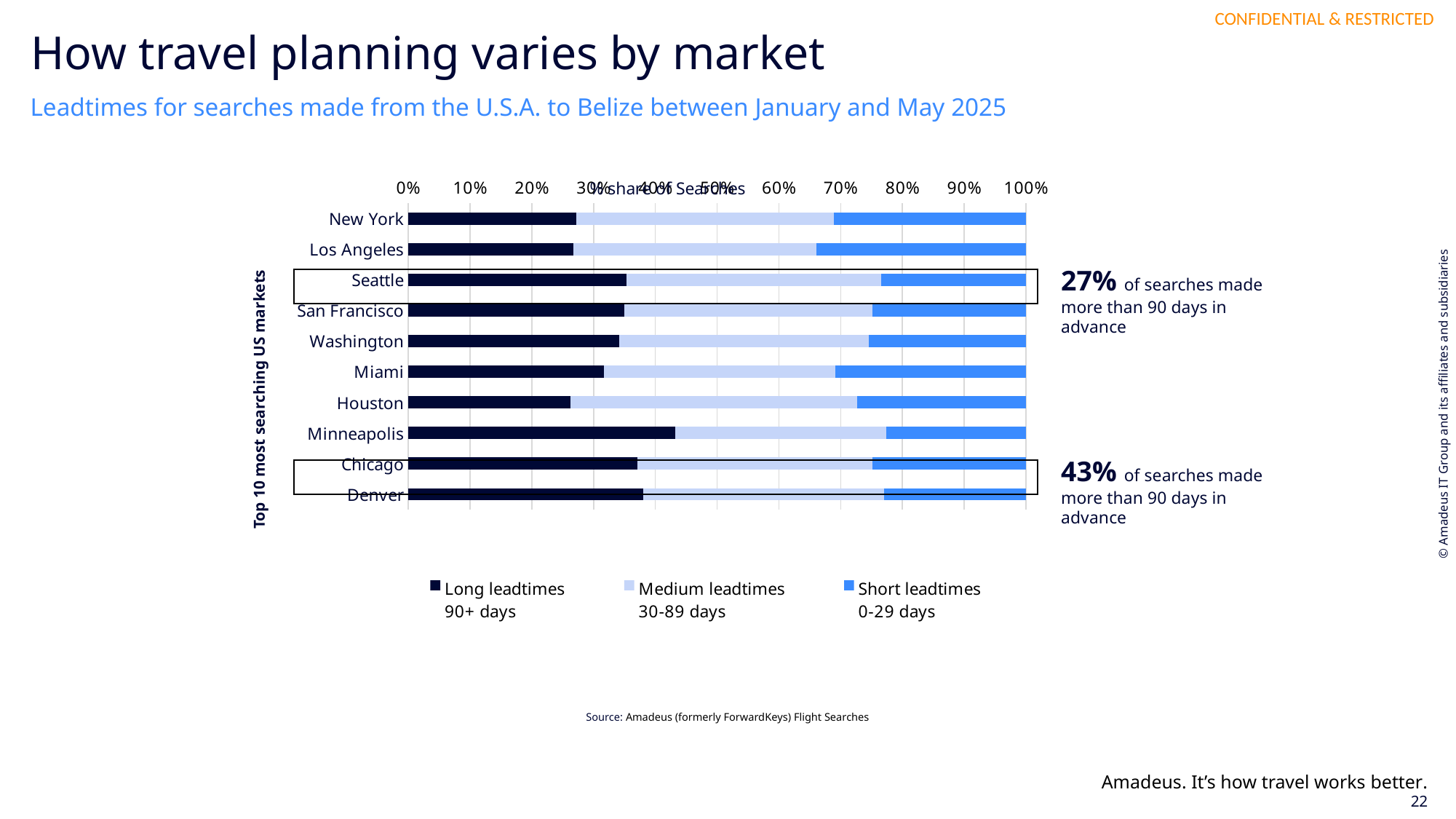
How many US markets are plotted on the chart? 10 Is the long leadtimes (90+ days) share for Seattle greater or less than 30%? greater Is the long leadtimes (90+ days) share for Houston greater or less than 30%? less What is the title of the vertical axis? Top 10 most searching US markets Which market has the highest share of long leadtimes (90+ days)? Minneapolis What value does each stacked bar total on the x axis? 100% What kind of chart is shown on the slide? Stacked bar chart Which has the larger share of short leadtimes (0-29 days), New York or Minneapolis? New York How many series does the legend list? 3 Which legend entry corresponds to 30-89 days? Medium leadtimes Is the long leadtimes (90+ days) share for Minneapolis greater or less than 40%? greater Which has the larger share of long leadtimes (90+ days), Minneapolis or New York? Minneapolis